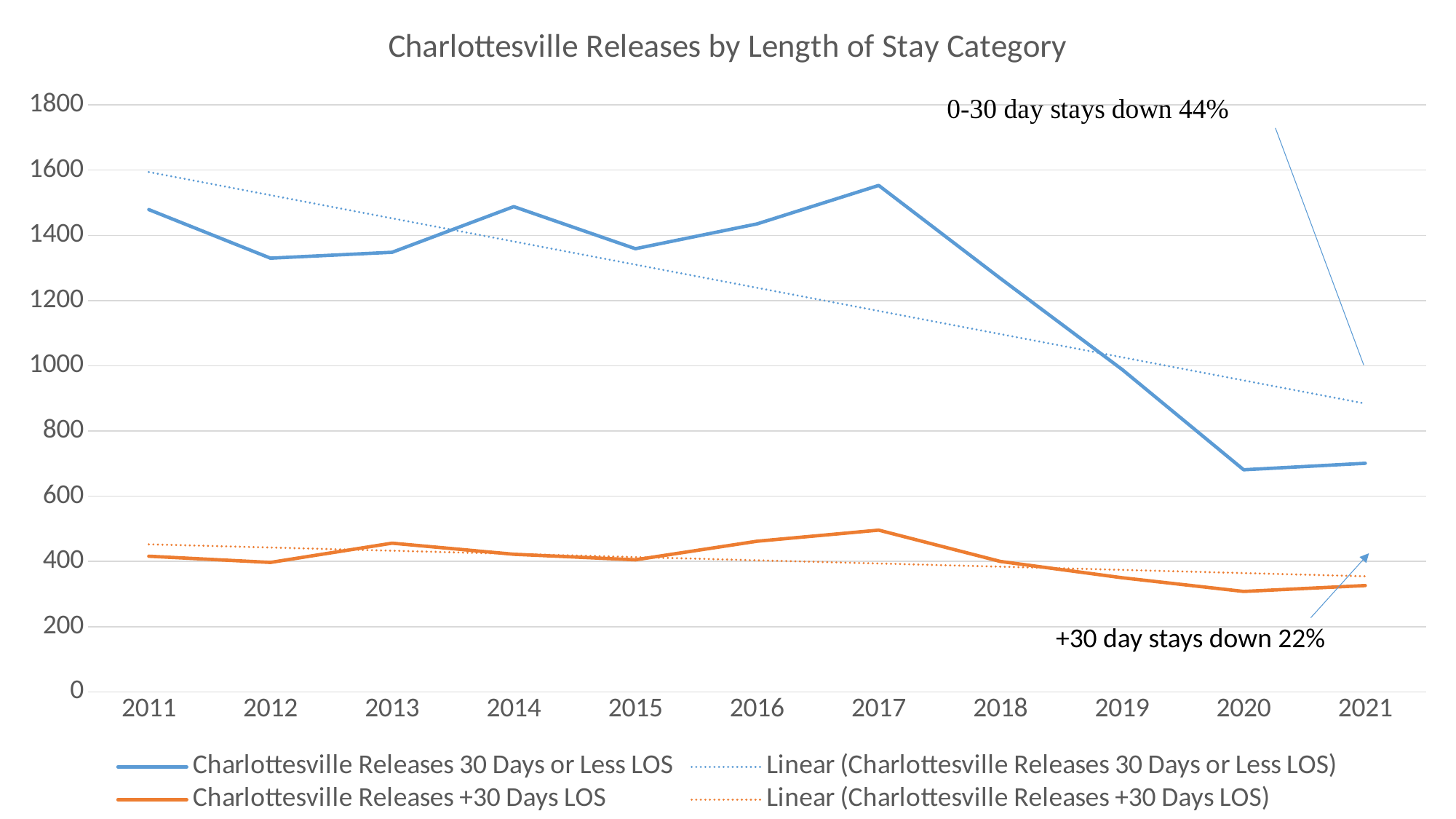
How many years are shown on the x axis? 11 Is the value for Charlottesville Releases 30 Days or Less LOS in 2020 greater or less than 800? less Is the value for Charlottesville Releases 30 Days or Less LOS in 2011 greater or less than 1400? greater Does the Charlottesville Releases 30 Days or Less LOS series rise or fall overall from 2011 to 2021? Fall Which year has the larger value for Charlottesville Releases 30 Days or Less LOS, 2012 or 2014? 2014 What kind of chart is shown on the slide? Line chart What is the title of the chart? Charlottesville Releases by Length of Stay Category How many entries does the legend list? 4 Is the value for Charlottesville Releases +30 Days LOS in 2020 greater or less than 400? less In which year is the value for Charlottesville Releases 30 Days or Less LOS highest? 2017 In which year is the value for Charlottesville Releases +30 Days LOS highest? 2017 According to the annotation on the chart, by what percentage are 0-30 day stays down? 44%